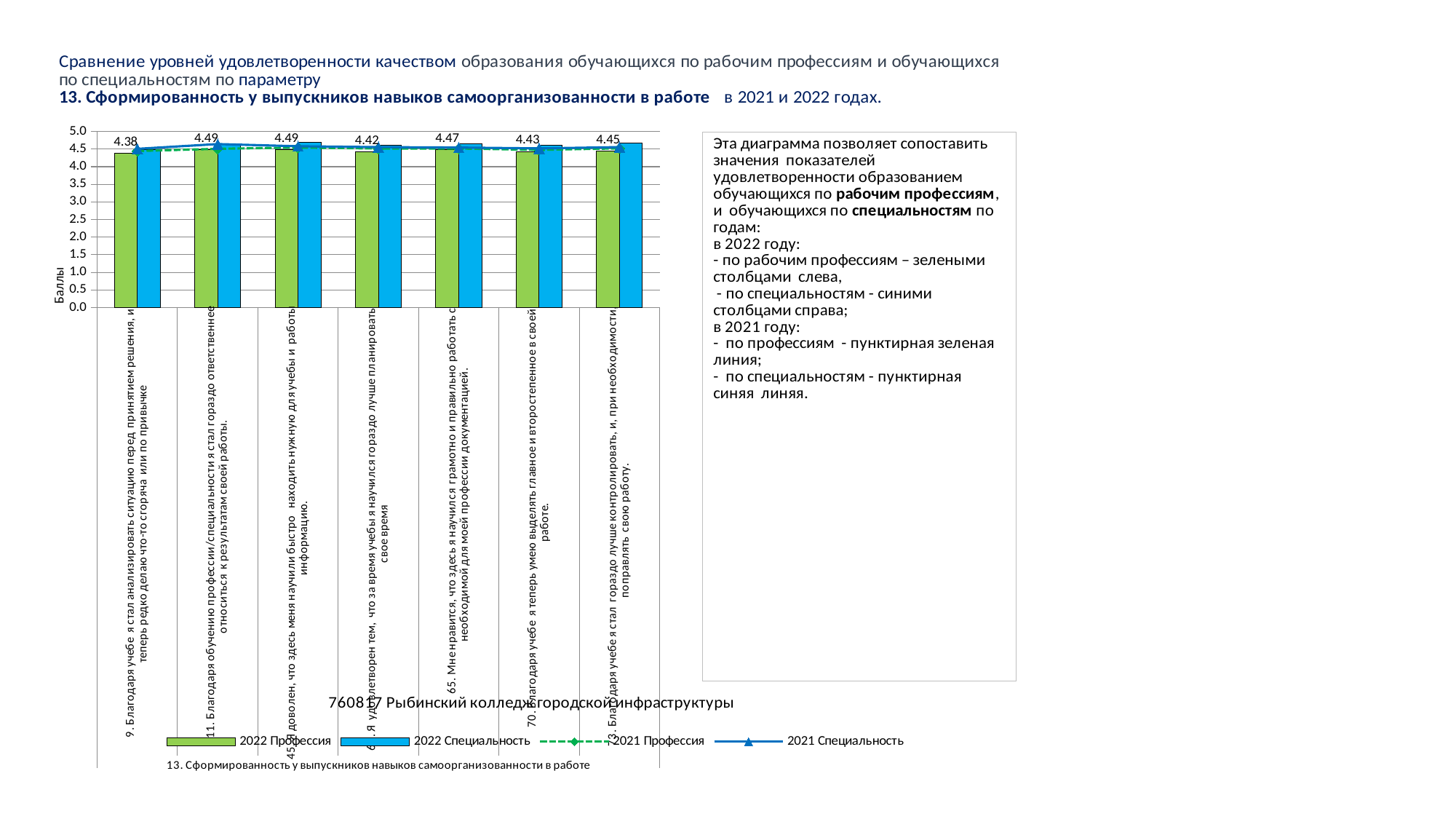
What are the four legend entries of the chart? 2022 Профессия, 2022 Специальность, 2021 Профессия, 2021 Специальность What data label is printed above the bars for item 11 (Благодаря обучению профессии/специальности я стал гораздо ответственнее)? 4.49 What is the title of the vertical axis of the chart? Баллы How many series does the chart legend list? 4 Which survey item has the lowest printed data label on the chart? Item 9 (4.38) Is the 2022 Специальность (blue) bar for item 73 greater or less than 5.0? less What data label is printed above the bars for item 9 (Благодаря учебе я стал анализировать ситуацию перед принятием решения)? 4.38 For item 9, which bar is taller: 2022 Профессия or 2022 Специальность? 2022 Специальность Is the 2022 Профессия (green) bar for item 9 greater or less than 4.0? greater How many categories (survey items) are plotted along the x axis of the chart? 7 What data label is printed above the bars for item 65 (Мне нравится, что здесь я научился грамотно и правильно работать с документацией)? 4.47 What kind of chart is shown on the slide? A bar chart combined with line series